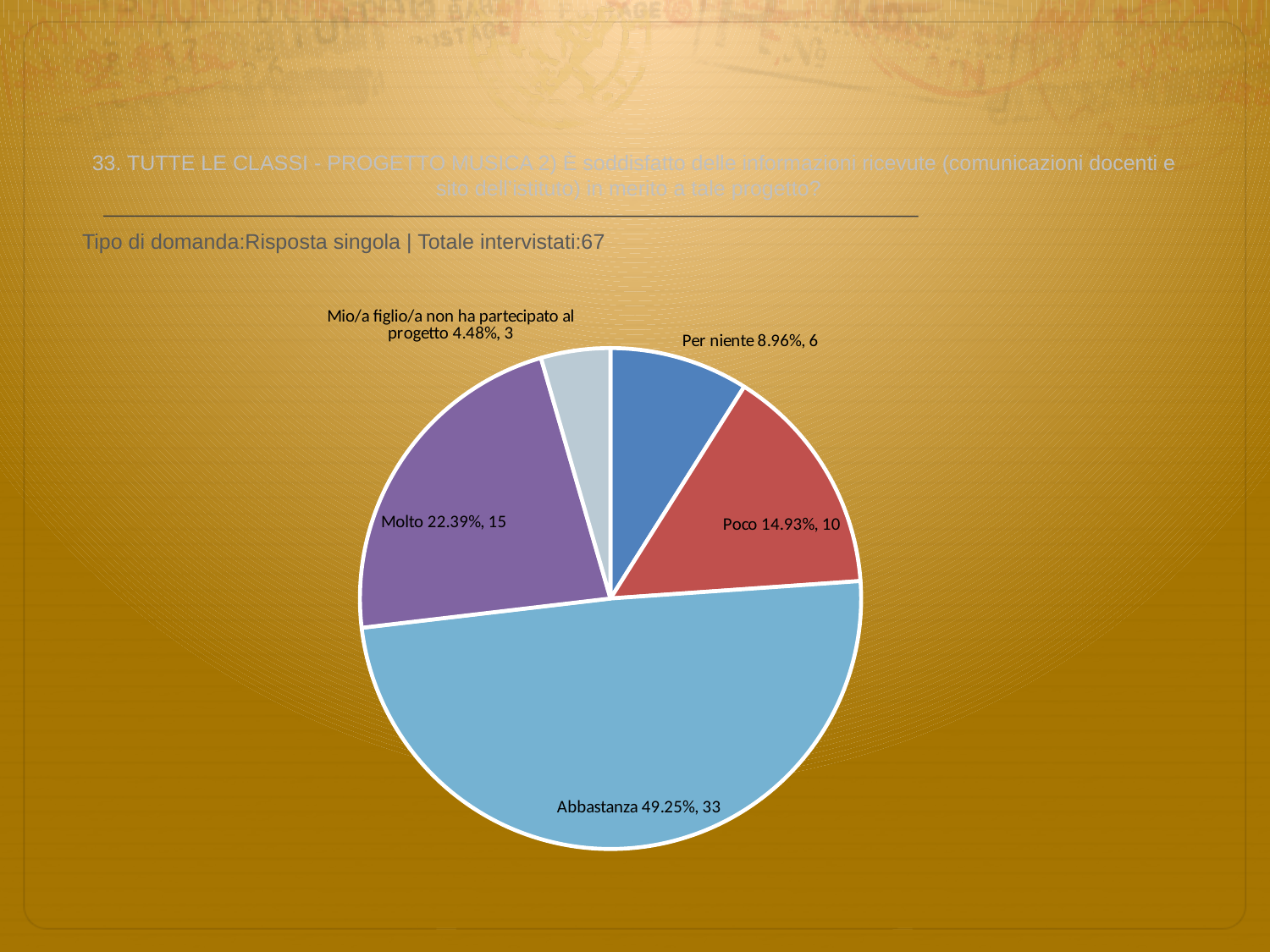
Which category has the largest slice? Abbastanza What kind of chart is shown on the slide? pie chart What is the total number of respondents stated on the slide? 67 What is the difference in respondent count between "Abbastanza" and "Molto"? 18 How many respondents answered "Poco"? 10 What colour is the "Molto" slice? purple Which has more respondents, "Poco" or "Per niente"? Poco What percentage share does the "Abbastanza" slice have? 49.25% What percentage share does the "Per niente" slice have? 8.96% How many respondents answered "Molto"? 15 Which category has the smallest slice? Mio/a figlio/a non ha partecipato al progetto How many slices does the pie chart have? 5